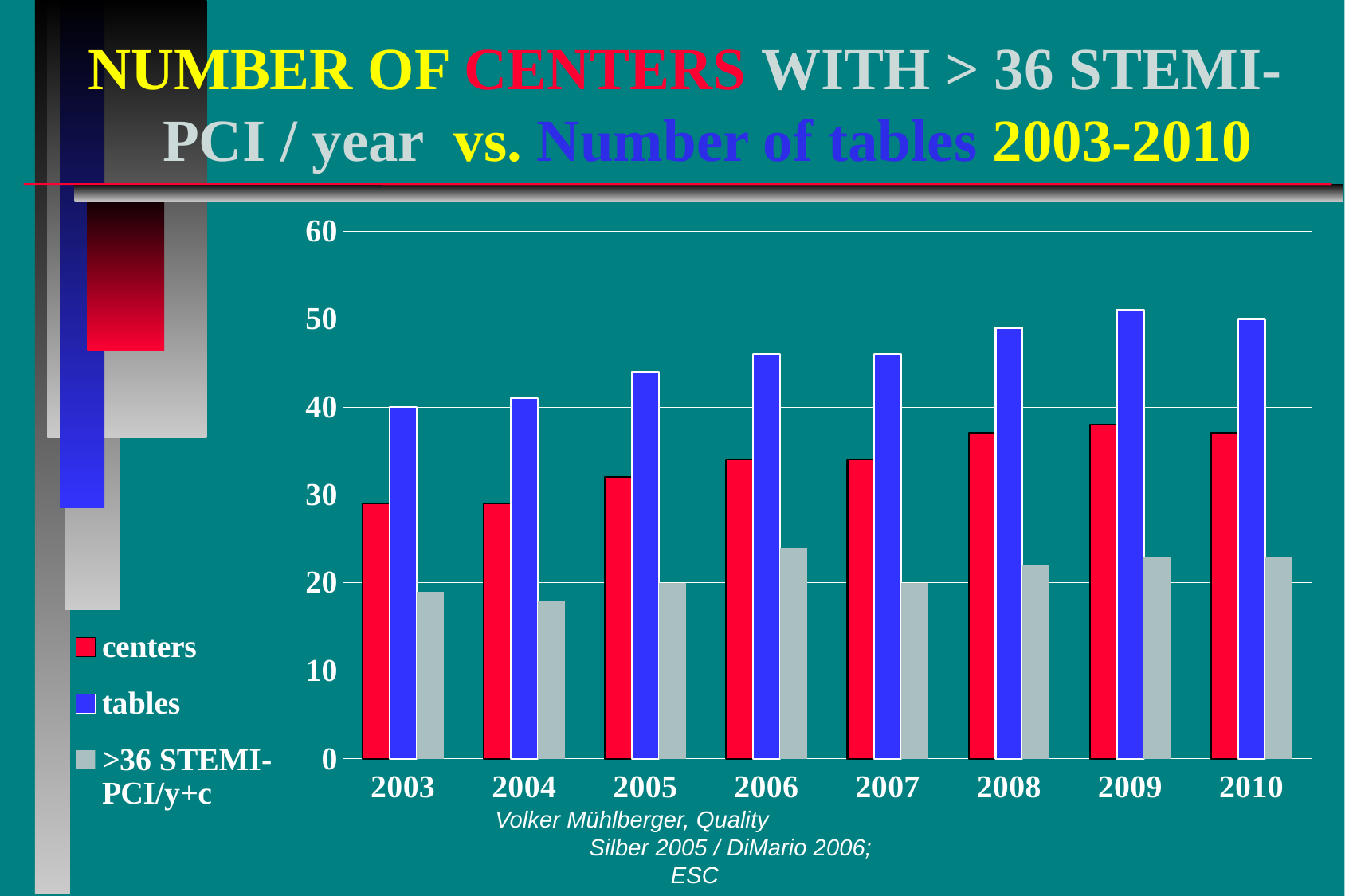
What kind of chart is shown on the slide? bar chart Is the value for centers in 2008 greater or less than 30? greater In 2006, which is larger: tables or centers? tables In 2003, which is larger: centers or >36 STEMI-PCI/y+c? centers Do the values for tables generally rise or fall from 2003 to 2009? rise Is the value for tables in 2009 greater or less than 50? greater Is the value for centers in 2003 greater or less than 30? less How many series does the legend list? 3 How many years are shown on the x axis? 8 What colour are the bars for the tables series? blue